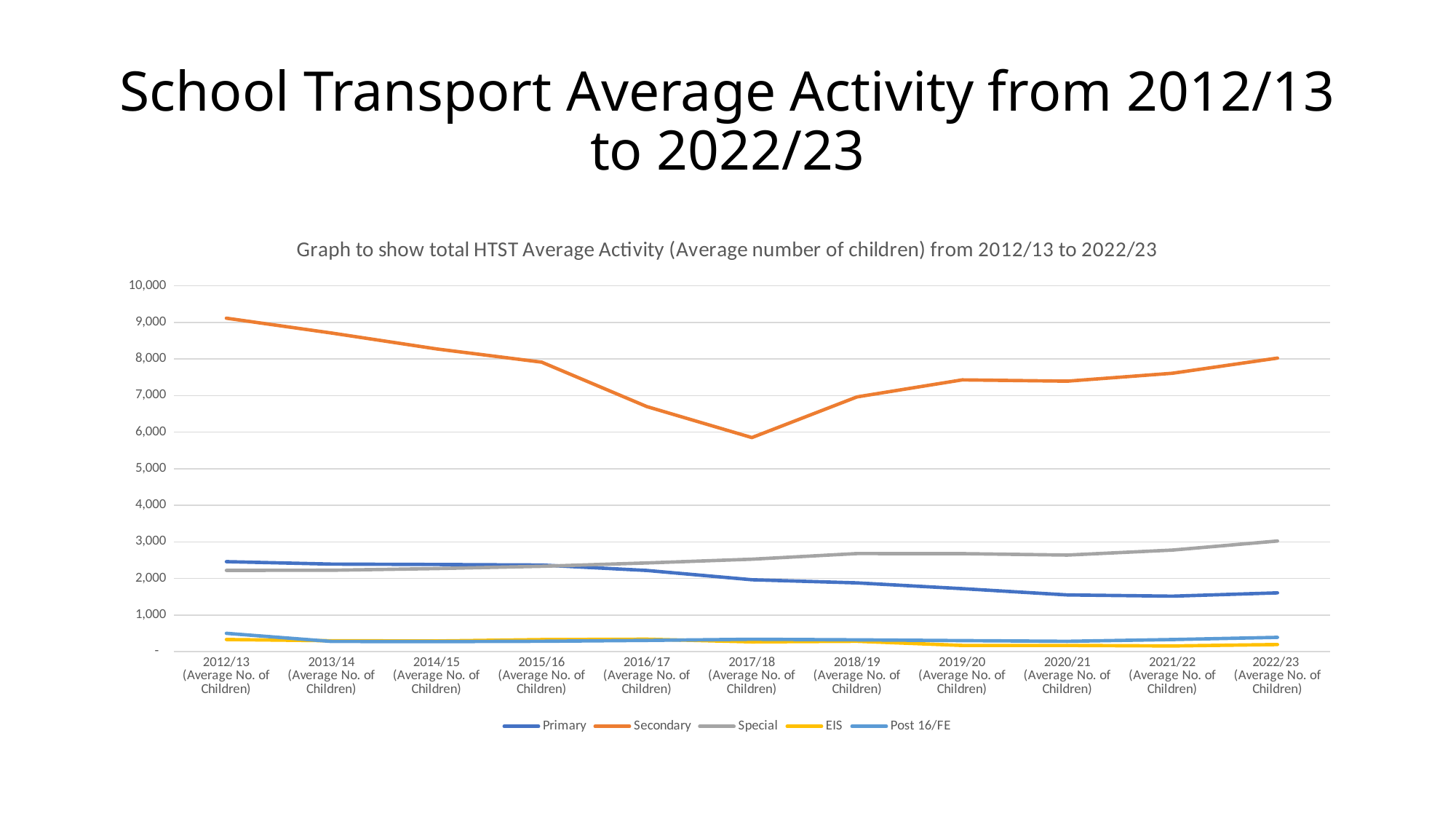
In which year does the Secondary series reach its highest value? 2012/13 How many series does the legend list? 5 Is the Primary value for 2021/22 greater or less than 2,000? less How many academic years are plotted along the x axis? 11 In 2022/23, which is larger: the Primary value or the Special value? Special Which series has the highest values across all years? Secondary What colour is the Secondary line? orange What kind of chart is shown on the slide? line chart Is the Secondary value for 2012/13 greater or less than 8,000? greater In which year does the Secondary series reach its lowest value? 2017/18 Does the Special series rise or fall from 2012/13 to 2022/23? rise Is the Secondary value for 2017/18 greater or less than 7,000? less